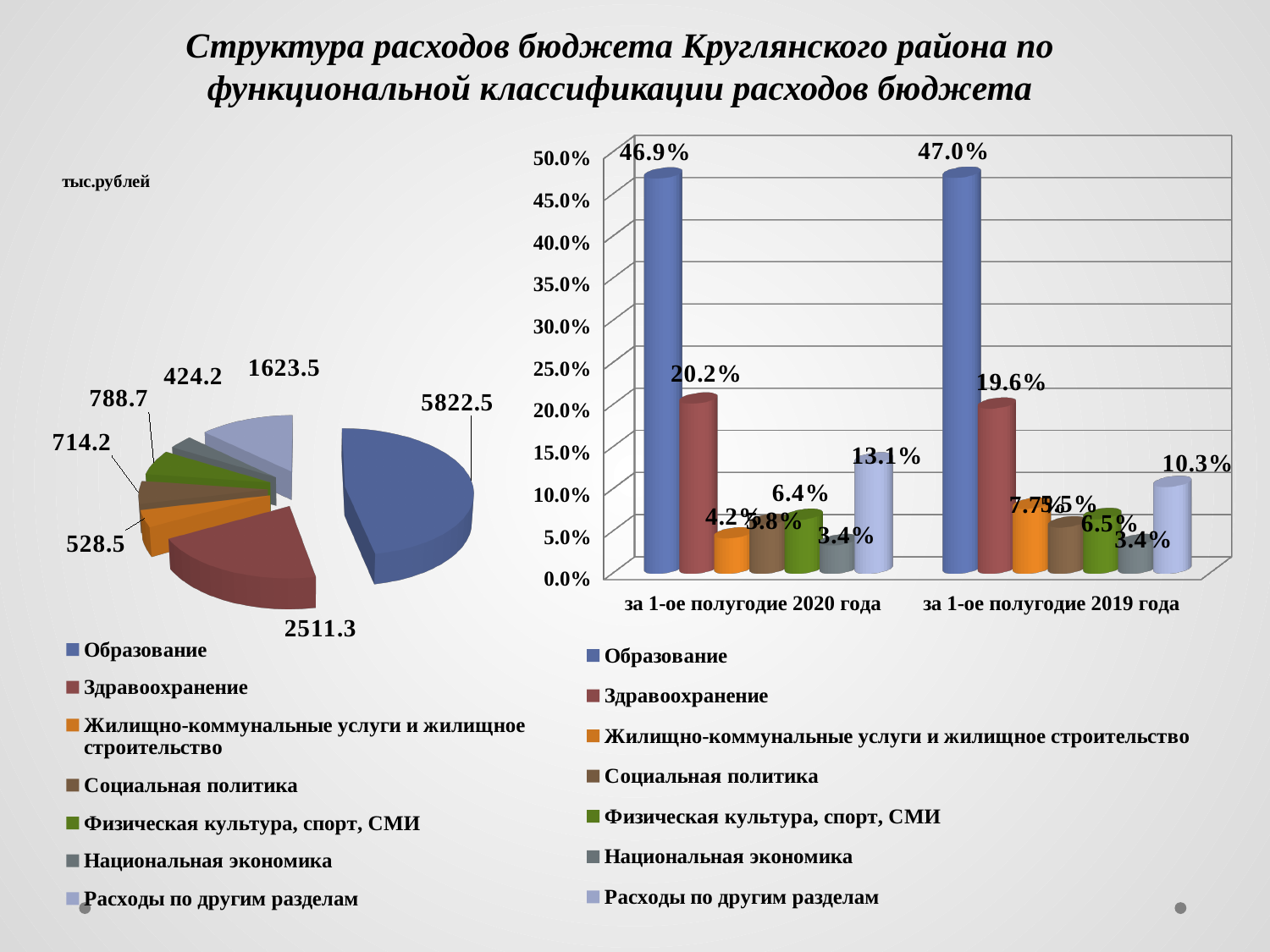
On the bar chart on the right, what is the value for Расходы по другим разделам за 1-ое полугодие 2019 года? 10.3% On the pie chart on the left, which category has the smallest value? Национальная экономика On the bar chart on the right, which is larger: Расходы по другим разделам за 1-ое полугодие 2020 года or за 1-ое полугодие 2019 года? за 1-ое полугодие 2020 года On the pie chart on the left, how many categories does the legend list? 7 On the pie chart on the left, what is the value for Образование? 5822.5 What kind of chart is the chart on the right? Bar chart On the bar chart on the right, what is the value for Здравоохранение за 1-ое полугодие 2019 года? 19.6% On the bar chart on the right, what is the value for Образование за 1-ое полугодие 2020 года? 46.9% On the pie chart on the left, which category has the largest value? Образование On the pie chart on the left, what is the difference between the values for Расходы по другим разделам and Физическая культура, спорт, СМИ? 834.8 On the bar chart on the right, what is the difference between Здравоохранение за 1-ое полугодие 2020 года and за 1-ое полугодие 2019 года? 0.6% On the pie chart on the left, what is the value for Здравоохранение? 2511.3